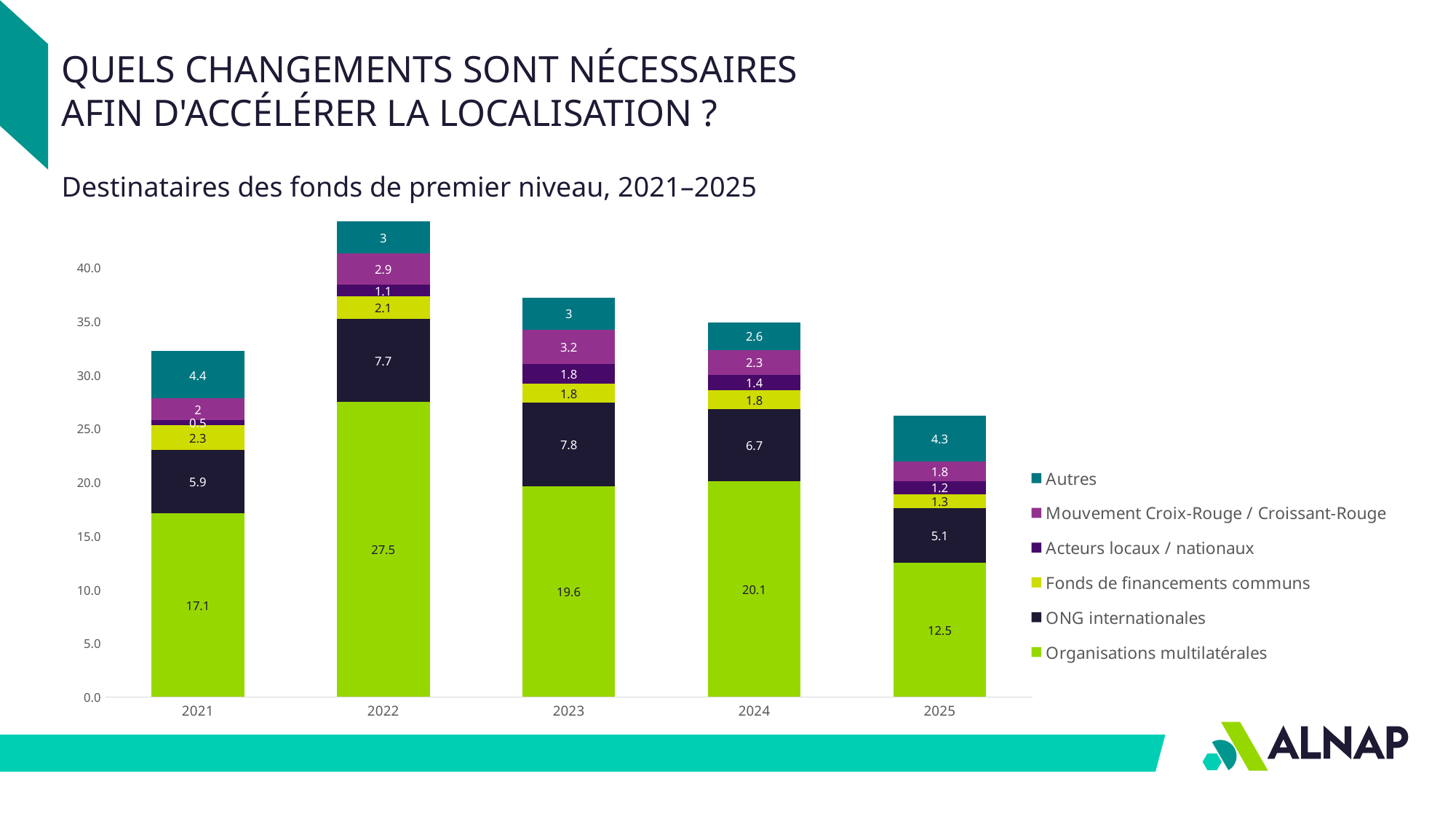
What is the value for Organisations multilatérales in 2022? 27.5 In which year is the value for Acteurs locaux / nationaux lowest? 2021 In which year is the value for Organisations multilatérales highest? 2022 What is the value for ONG internationales in 2024? 6.7 How many years are shown on the x axis? 5 Which is larger: the Mouvement Croix-Rouge / Croissant-Rouge value in 2023 or in 2024? 2023 What is the value for Autres in 2025? 4.3 What kind of chart is shown on the slide? Stacked bar chart How many series does the legend list? 6 Is the total of the stacked bar for 2022 greater or less than 40.0? greater What is the difference between the Organisations multilatérales values in 2022 and 2025? 15 What is the total of the stacked bar for 2025? 26.2